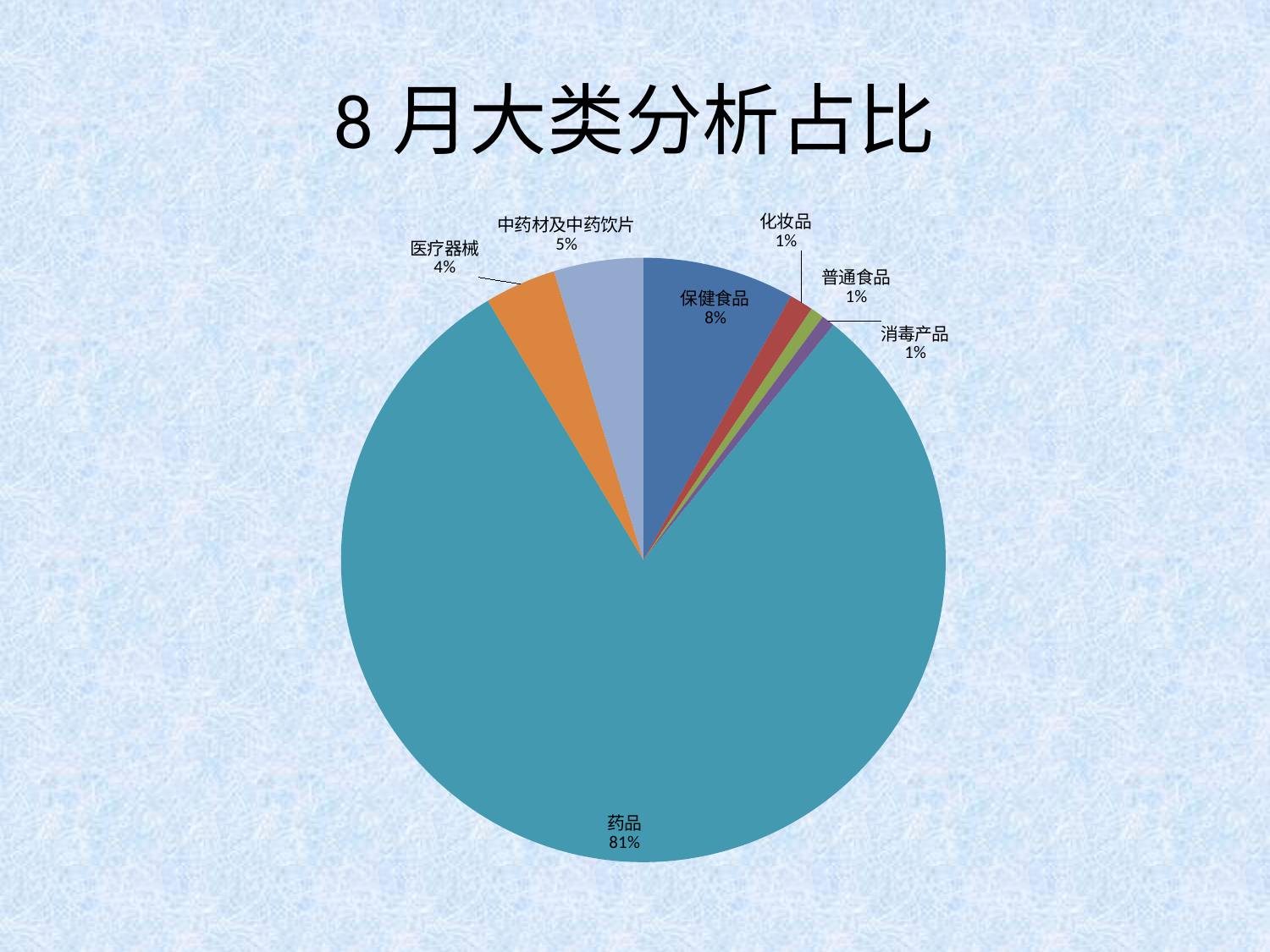
What is the difference in percentage points between 保健食品 and 医疗器械? 4 What is the title of the chart? 8 月大类分析占比 What share of the pie does 化妆品 have? 1% How many slices does the pie chart have? 7 Which is larger, the share for 中药材及中药饮片 or the share for 医疗器械? 中药材及中药饮片 What share of the pie does 药品 have? 81% What share of the pie does 中药材及中药饮片 have? 5% What is the difference in percentage points between 药品 and 保健食品? 73 Which category has the largest slice of the pie? 药品 What kind of chart is shown on the slide? pie chart